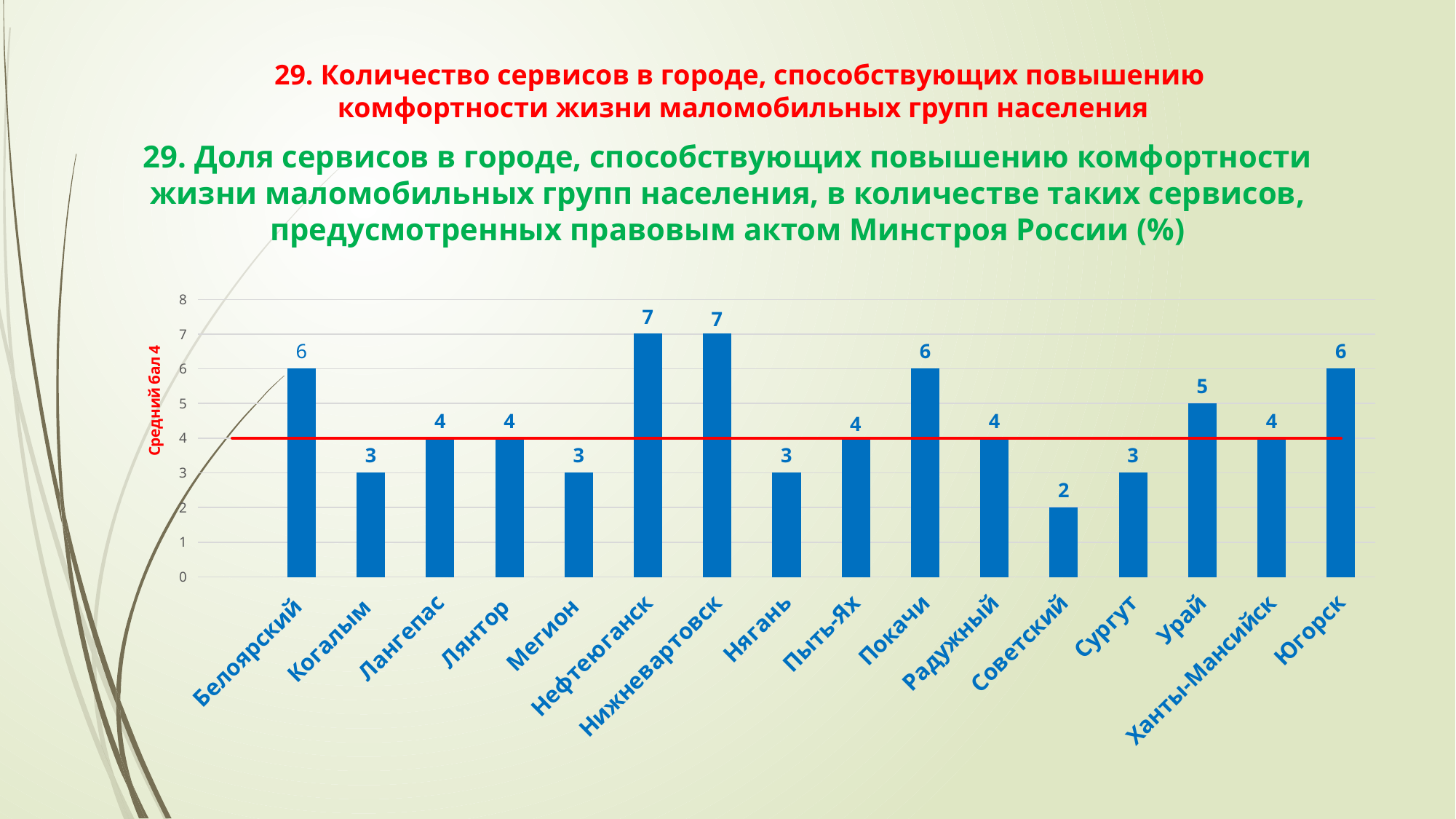
Which city has the lowest value on the chart? Советский Which two cities share the highest value on the chart? Нефтеюганск and Нижневартовск What is the difference between the values for Югорск and Сургут? 3 What value is shown for Ханты-Мансийск? 4 What is the label written in red along the vertical axis of the chart? Средний бал 4 What kind of chart is shown on the slide? Bar chart Which is larger, the value for Покачи or the value for Мегион? Покачи What value is shown for Советский? 2 What value is shown for Нефтеюганск? 7 What value is shown for Урай? 5 What value does the red horizontal line on the chart mark? 4 How many cities are shown on the x axis of the chart? 16